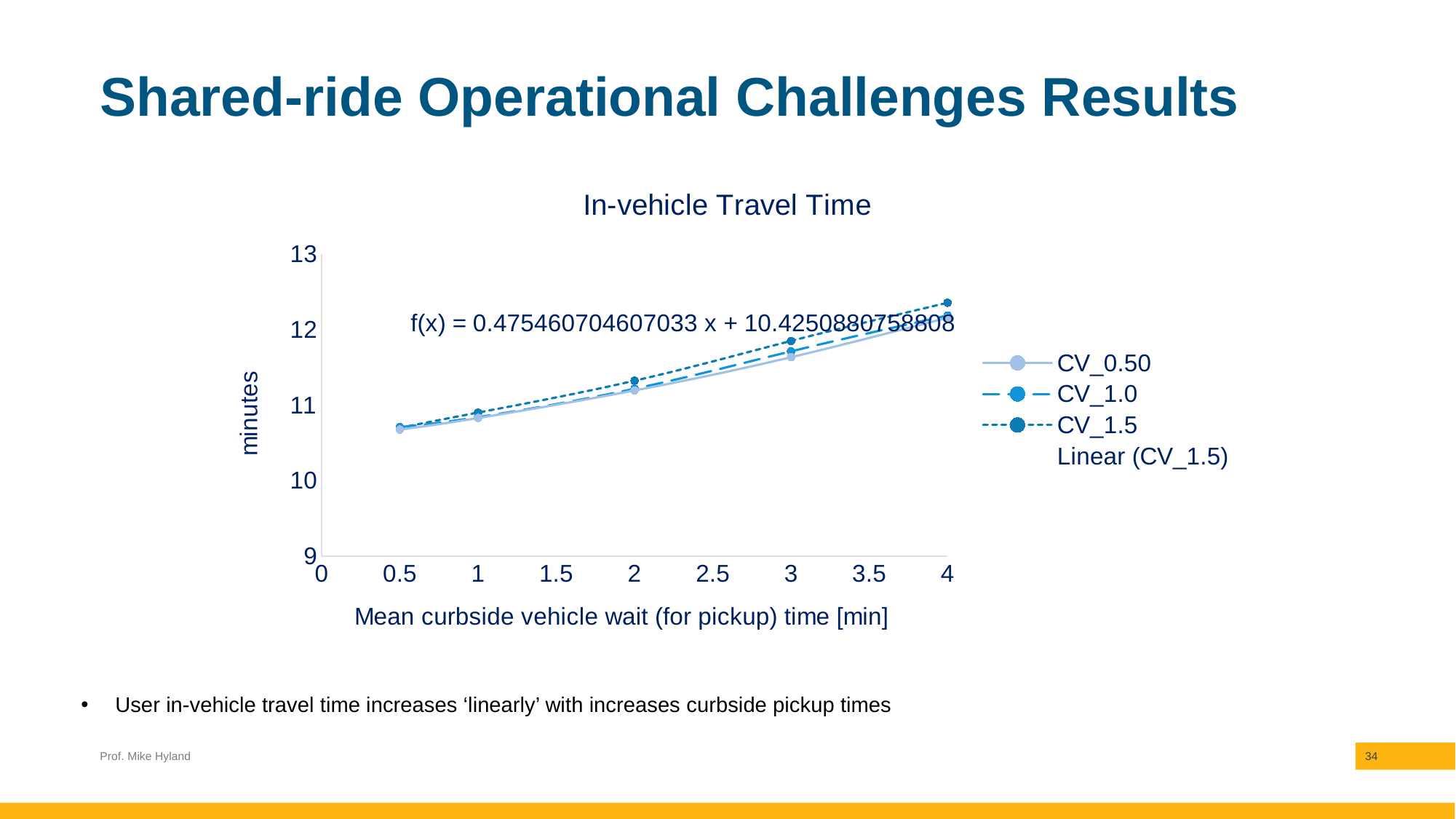
Is the CV_1.5 value at a mean curbside wait time of 4 minutes greater or less than 12? greater How many data points are plotted for the CV_1.5 series? 5 What is the title of the chart? In-vehicle Travel Time How many entries does the chart's legend list? 4 Do the in-vehicle travel time values rise or fall as the mean curbside vehicle wait time increases? Rise Which series has the highest value at a mean curbside wait time of 4 minutes? CV_1.5 Is the CV_0.50 value at a mean curbside wait time of 3 minutes greater or less than 12? less What kind of chart is shown on the slide? Line chart What is the label of the x axis? Mean curbside vehicle wait (for pickup) time [min] Is the CV_0.50 value at a mean curbside wait time of 0.5 minutes greater or less than 11? less At a mean curbside wait time of 3 minutes, which series has the higher value, CV_1.5 or CV_0.50? CV_1.5